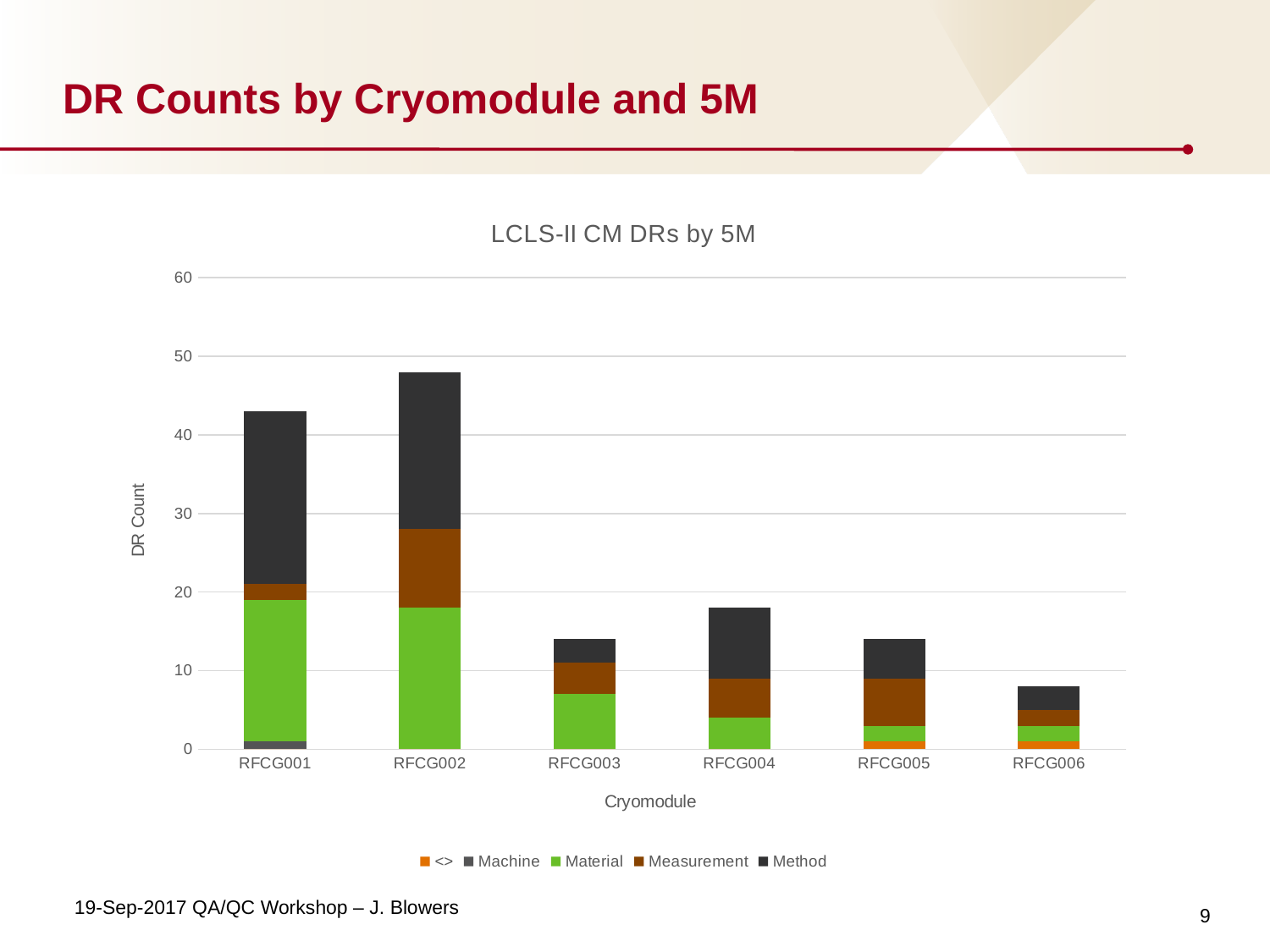
What type of chart is shown on the slide? Stacked bar chart Which cryomodule has the highest total DR count? RFCG002 What is the title of the chart? LCLS-II CM DRs by 5M Which has a larger total DR count, RFCG001 or RFCG004? RFCG001 How many series does the legend list? 5 Is the total DR count for RFCG003 greater or less than 10? greater What is the label of the y axis? DR Count Is the total DR count for RFCG002 greater or less than 40? greater Which cryomodule has the lowest total DR count? RFCG006 Is the total DR count for RFCG006 greater or less than 10? less How many cryomodule categories are shown on the x axis? 6